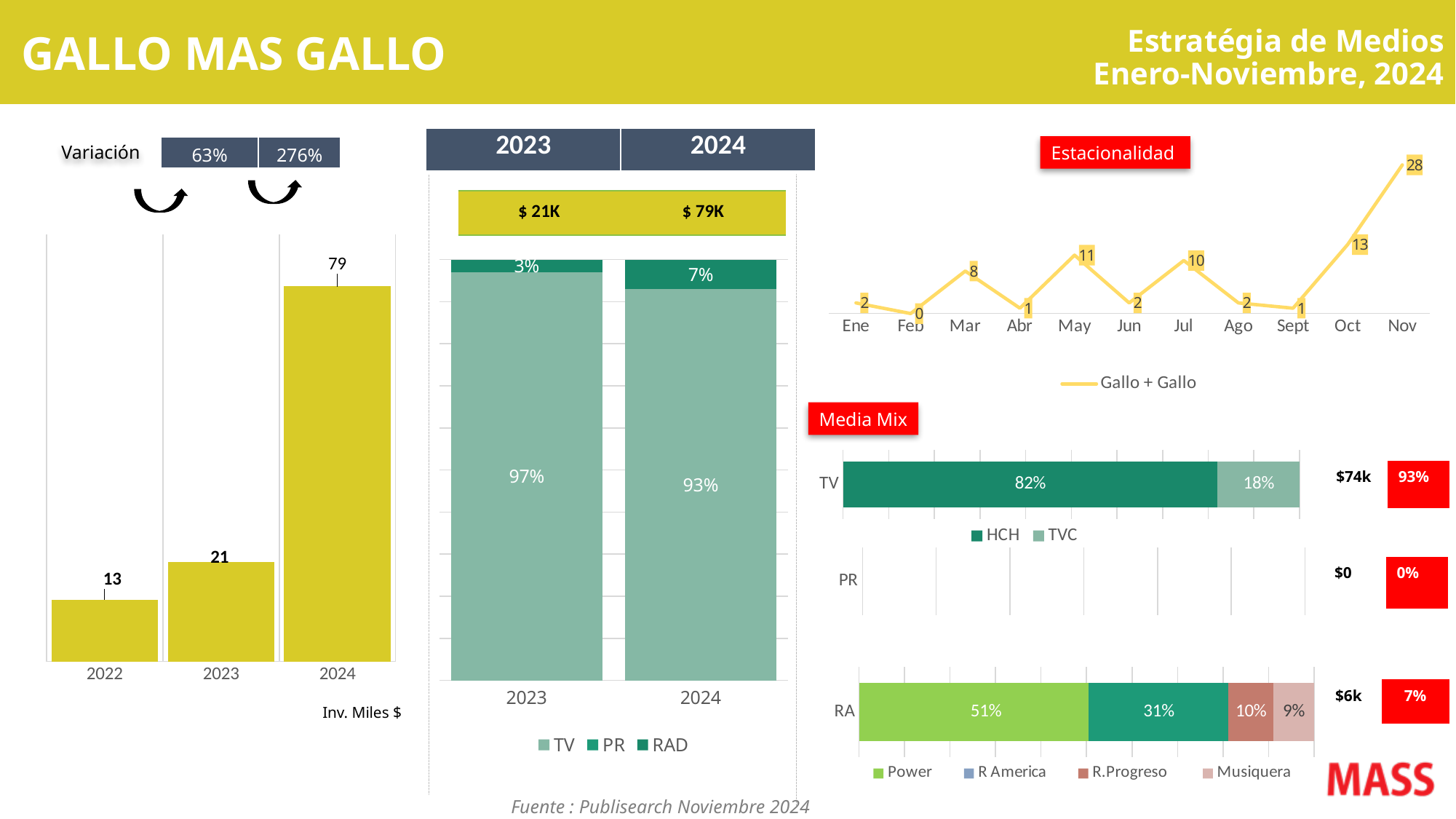
In the middle stacked bar chart, how many series does the legend list? 3 In the Estacionalidad chart, what is the value for Nov? 28 In the Estacionalidad chart, what kind of chart is shown? line chart In the Media Mix chart, what is the Power share of the RA bar? 51% In the Media Mix chart, what is the HCH share of the TV bar? 82% In the left bar chart (Inv. Miles $), what is the difference between the 2024 and 2023 values? 58 In the left bar chart (Inv. Miles $), which year has the lowest value? 2022 In the Estacionalidad chart, which month has the highest value? Nov In the left bar chart (Inv. Miles $), how many years are shown? 3 In the middle stacked bar chart, what is the TV share for 2024? 93% In the Estacionalidad chart, what is the difference between the Oct and Jul values? 3 In the left bar chart (Inv. Miles $), what is the value for 2024? 79